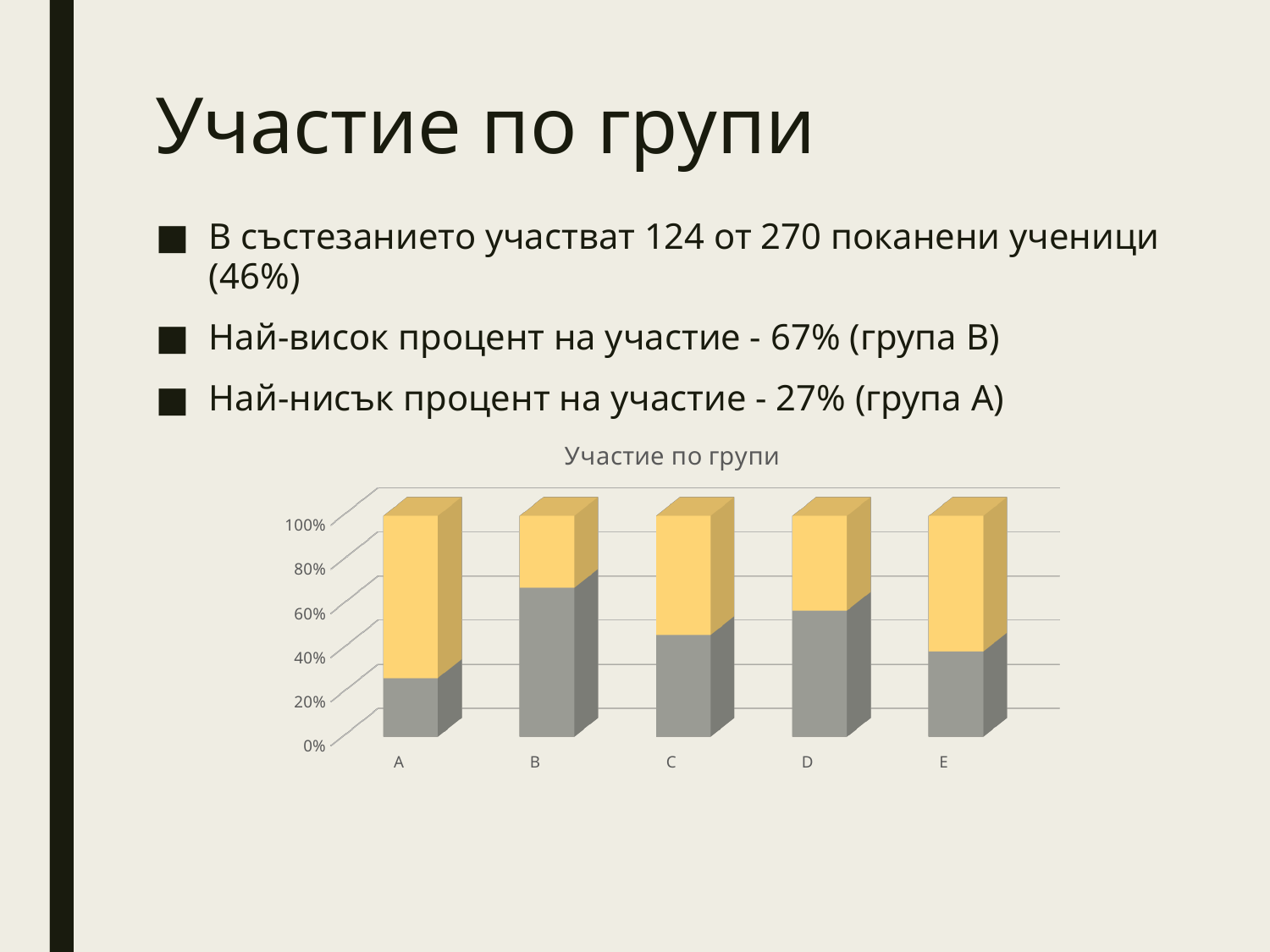
Which group has the lowest participation percentage (smallest gray segment)? A Is the participation percentage (gray segment) for group C greater or less than 40%? greater Which group has the highest participation percentage (largest gray segment)? B What is the participation percentage for group B? 67% Is the participation percentage (gray segment) for group E greater or less than 60%? less What is the title of the chart? Участие по групи How many groups (categories) are shown on the x axis of the chart? 5 Which group has a larger participation percentage, C or D? D What kind of chart is shown on the slide? Stacked bar chart What is the difference between the participation percentages of group B and group A? 40% What is the total height of each stacked bar in the chart? 100% What is the participation percentage for group A? 27%